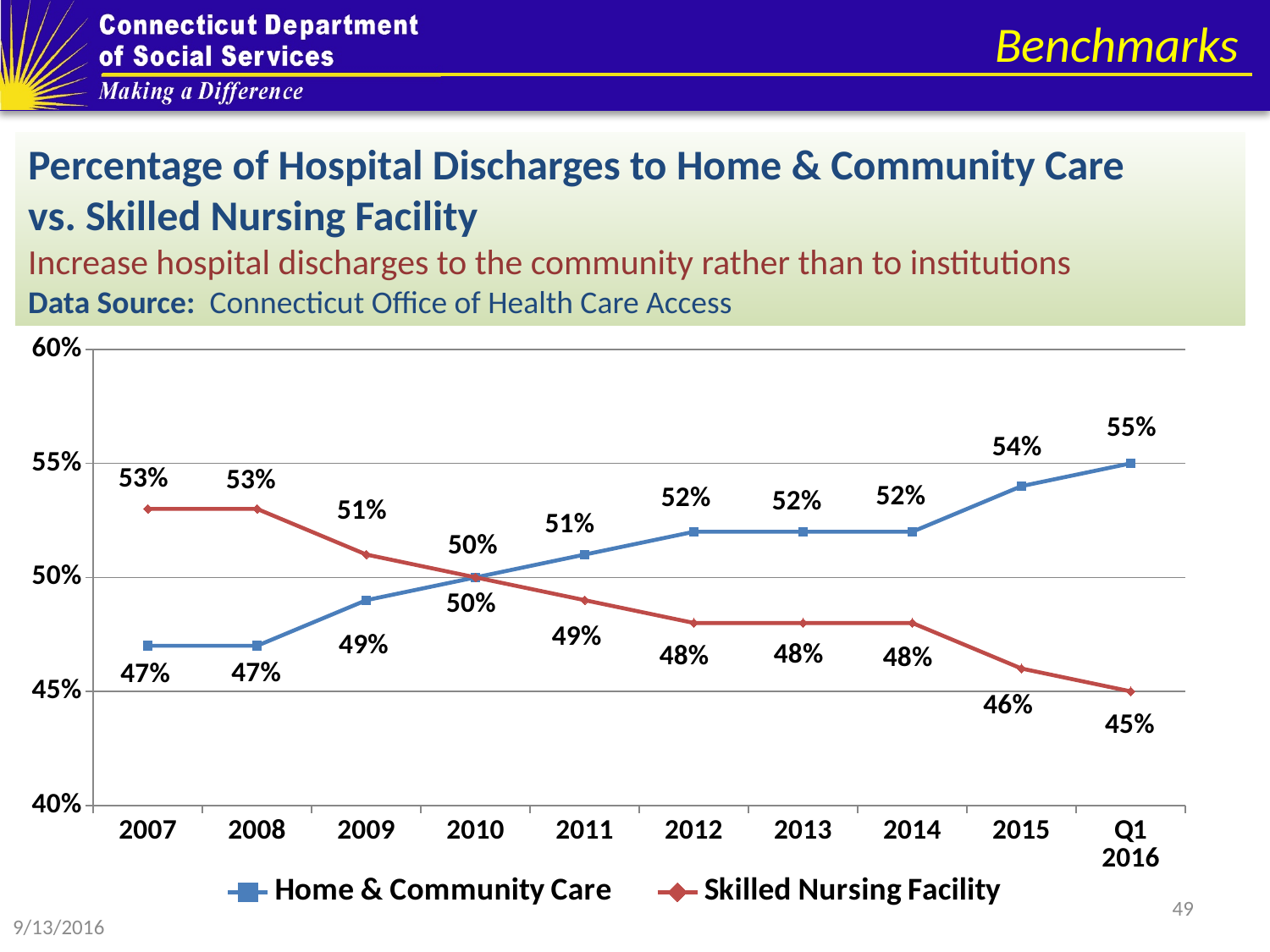
What is the difference between Home & Community Care and Skilled Nursing Facility in Q1 2016? 10% Does the Skilled Nursing Facility series rise or fall from 2007 to Q1 2016? Fall Which series has the larger value in 2008, Home & Community Care or Skilled Nursing Facility? Skilled Nursing Facility What kind of chart is shown on the slide? Line chart In which year does Home & Community Care reach its highest value? Q1 2016 What is the value for Home & Community Care in 2007? 47% How many time periods are shown on the x axis? 10 What is the value for Skilled Nursing Facility in 2009? 51% How many series does the legend list? 2 What is the value for Home & Community Care in 2015? 54% What is the value for Skilled Nursing Facility in Q1 2016? 45% In which year is Skilled Nursing Facility at its lowest value? Q1 2016